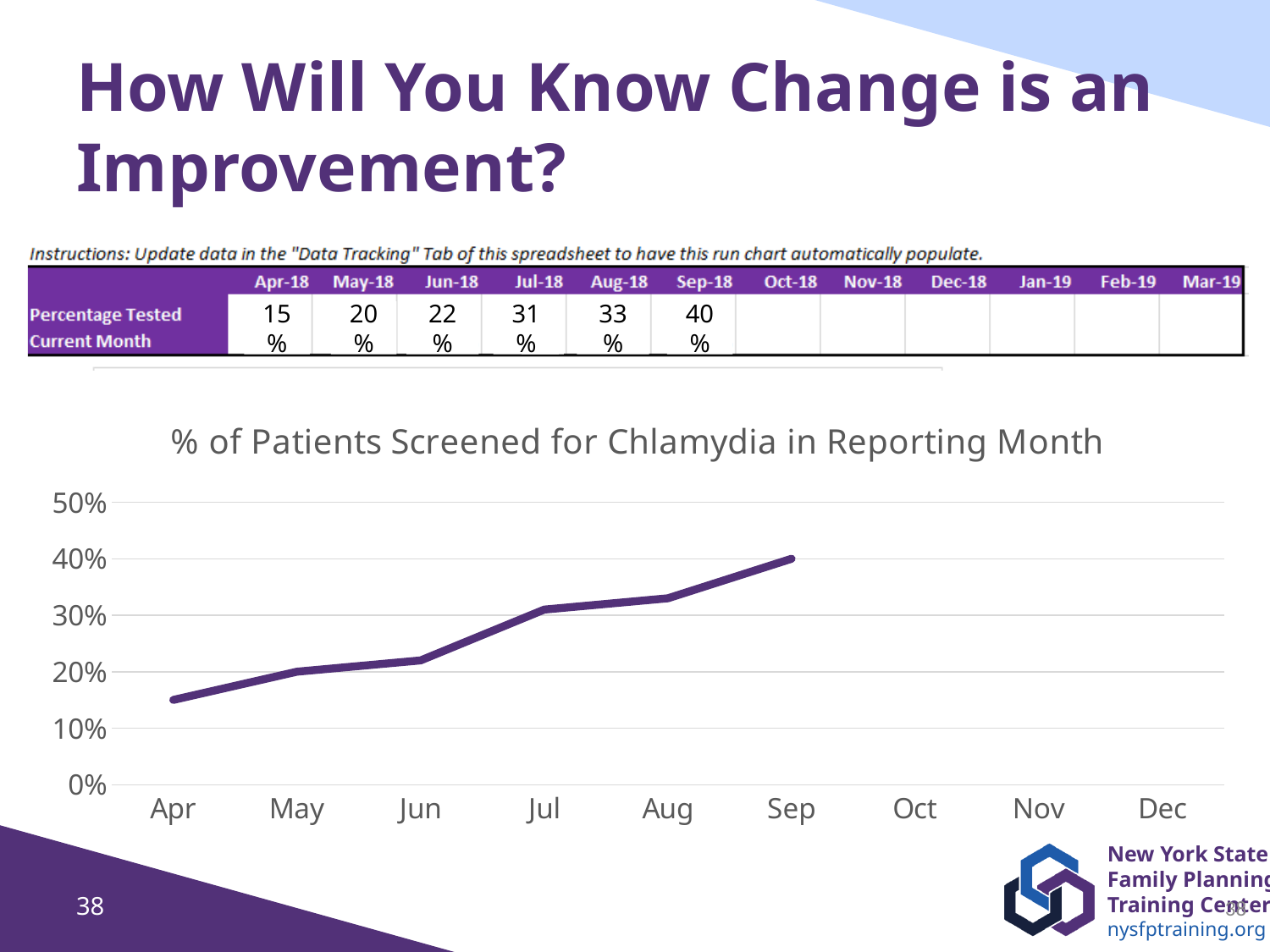
What is the difference between the percentage tested in Sep-18 and Apr-18? 25% Is the value for Jul greater or less than 30%? greater How many months have a plotted data point on the chart? 6 According to the table, what percentage of patients were tested in Apr-18? 15% What is the title of the chart? % of Patients Screened for Chlamydia in Reporting Month Is the percentage tested higher in Jun or in Aug? Aug What kind of chart is shown on the slide? line chart Which month has the lowest percentage tested on the chart? Apr According to the table, what percentage of patients were tested in Jul-18? 31% According to the table, what percentage of patients were tested in Sep-18? 40% Do the values rise or fall from Apr to Sep? rise Which month has the highest percentage tested on the chart? Sep